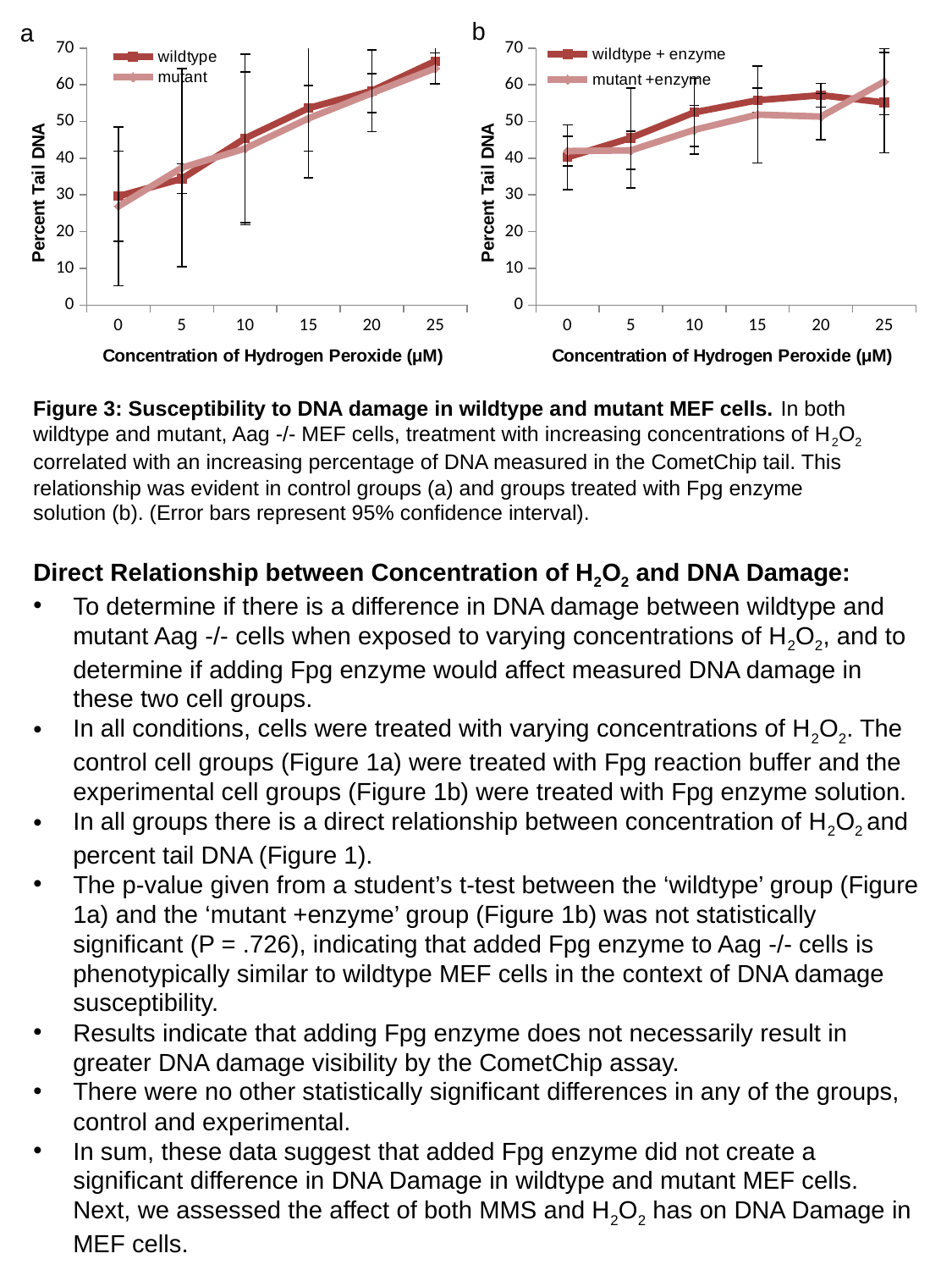
In chart a, is the wildtype value at 25 µM greater or less than 60? greater In chart b, at which concentration is the mutant +enzyme series highest? 25 In chart a, does the wildtype series rise or fall as the concentration of hydrogen peroxide increases? rise In chart a, is the wildtype value at 0 µM greater or less than 40? less In chart b, is the mutant +enzyme value at 25 µM greater or less than 50? greater How many series does the legend of chart b list? 2 What is the y-axis title of chart b? Percent Tail DNA In chart a, at which concentration is the wildtype series lowest? 0 How many hydrogen peroxide concentrations are plotted along the x axis of chart a? 6 What are the two series named in the legend of chart b? wildtype + enzyme and mutant +enzyme What kind of chart is chart a? line chart